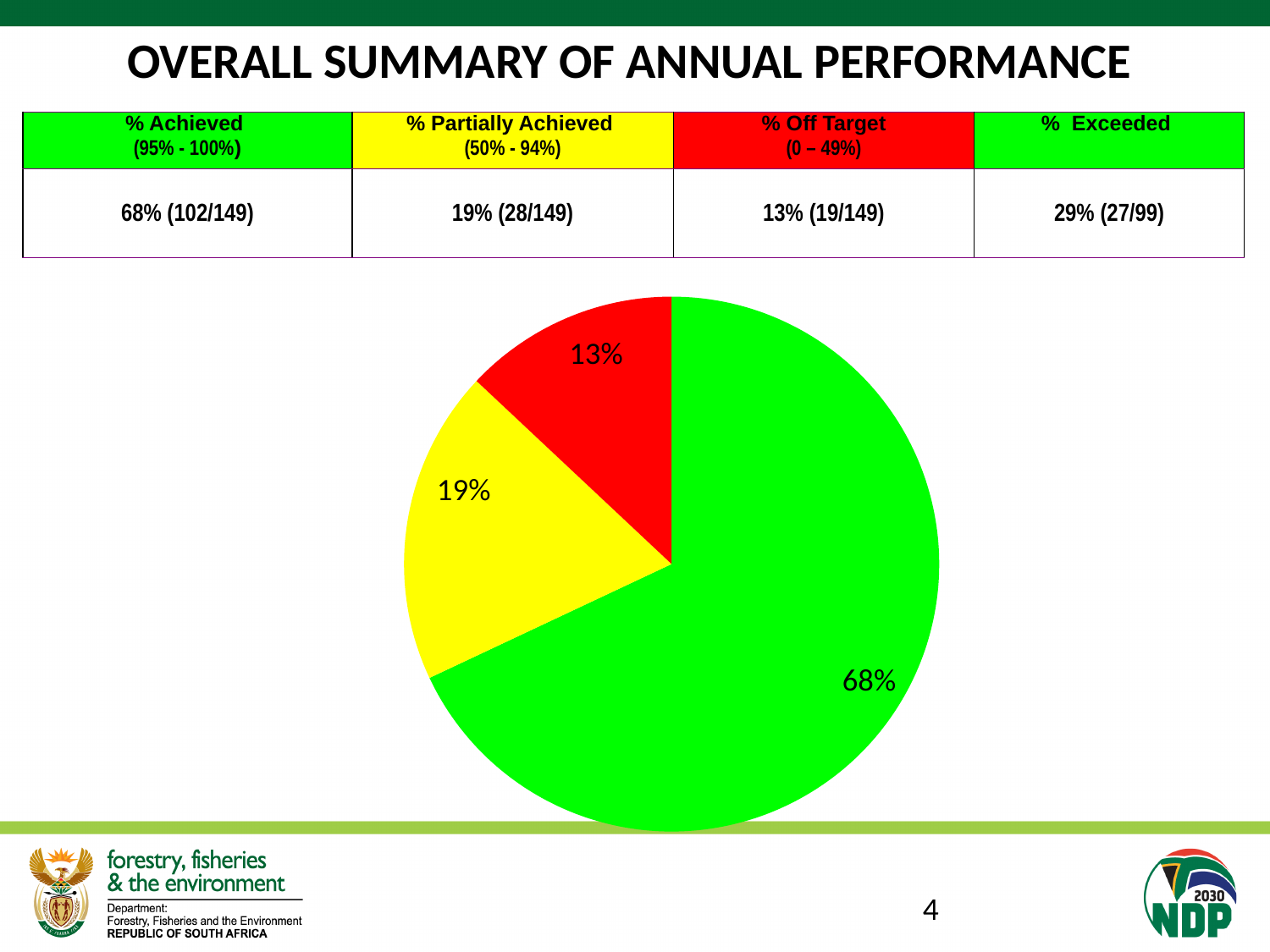
What percentage is shown on the red slice of the pie chart? 13% What percentage is shown on the yellow slice of the pie chart? 19% What colour is the largest slice of the pie chart? green Which slice of the pie chart is the largest? the green slice (68%) What is the difference between the yellow slice and the red slice of the pie chart? 6% What percentage is shown on the green slice of the pie chart? 68% Which slice of the pie chart is the smallest? the red slice (13%) How many slices does the pie chart have? 3 Which is larger in the pie chart, the yellow slice or the red slice? the yellow slice What share of the pie does the green slice represent? 68% What is the difference between the green slice and the yellow slice of the pie chart? 49% What kind of chart is shown on the slide? pie chart